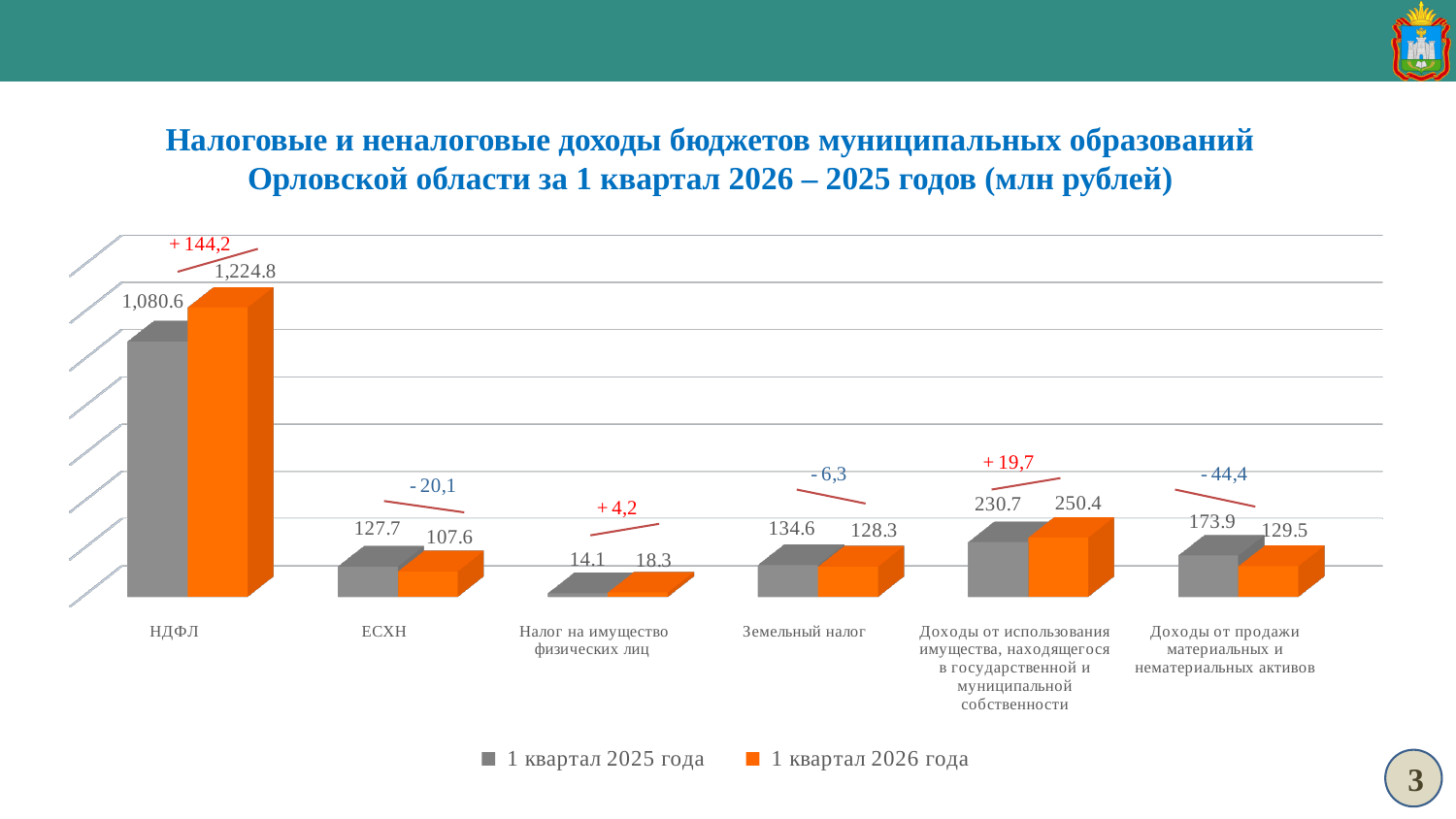
What kind of chart is shown on the slide? Bar chart Which category has the lowest value in the series 1 квартал 2025 года? Налог на имущество физических лиц How many series does the legend list? 2 Which category has the highest value in the series 1 квартал 2026 года? НДФЛ What is the value for ЕСХН in the series 1 квартал 2025 года? 127.7 How many categories are shown on the x axis of the chart? 6 What is the value for Земельный налог in the series 1 квартал 2026 года? 128.3 What is the value for Налог на имущество физических лиц in the series 1 квартал 2025 года? 14.1 What is the difference between the 1 квартал 2026 года and 1 квартал 2025 года values for Доходы от продажи материальных и нематериальных активов? 44.4 What is the value for НДФЛ in the series 1 квартал 2026 года? 1,224.8 For Доходы от использования имущества, находящегося в государственной и муниципальной собственности, which series has the larger value: 1 квартал 2025 года or 1 квартал 2026 года? 1 квартал 2026 года Which colour represents the series 1 квартал 2026 года in the chart? Orange